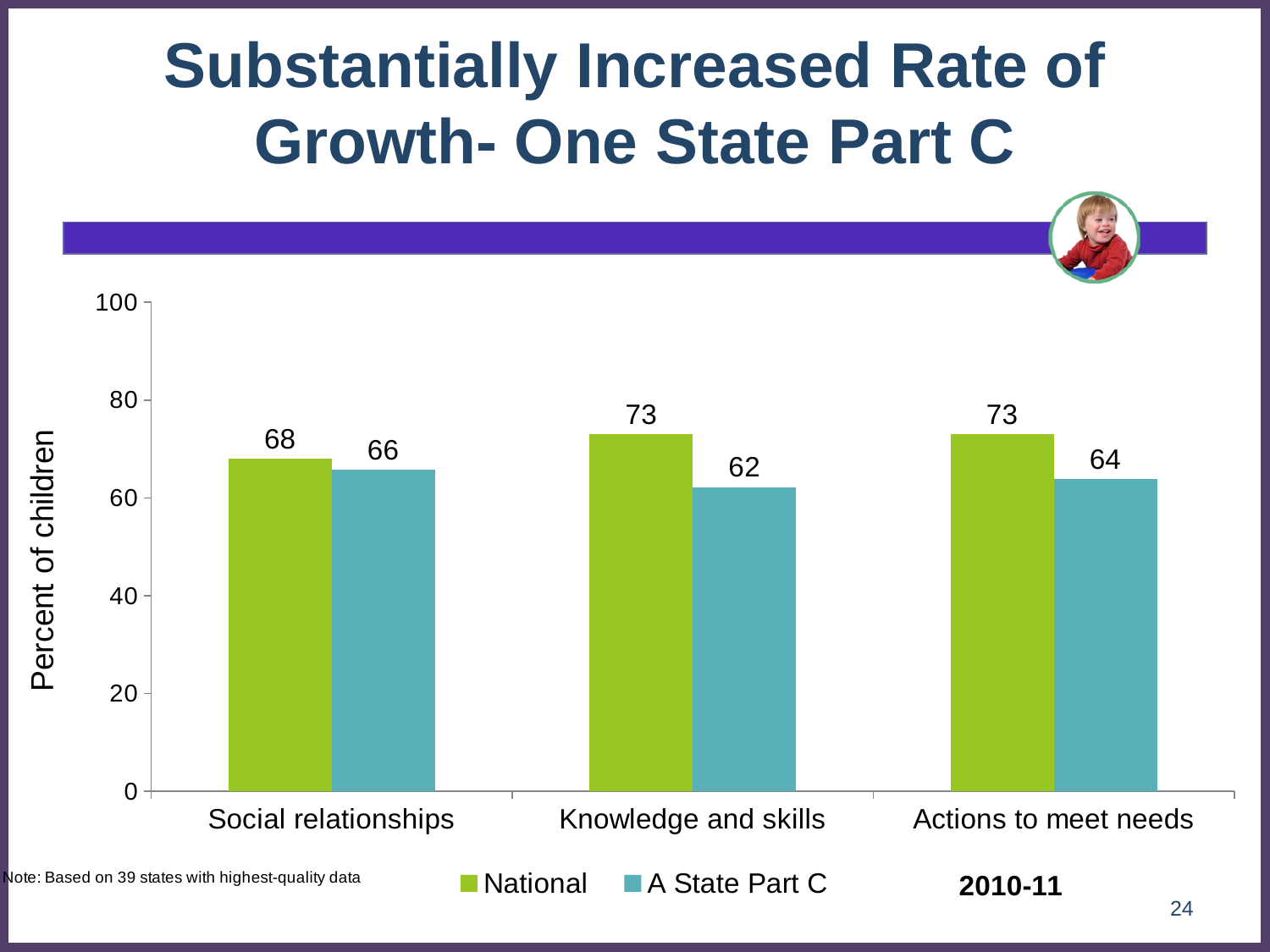
What is the A State Part C value for Knowledge and skills? 62 Which is larger for Social relationships, the National value or the A State Part C value? National How many categories are shown on the x axis? 3 What is the label of the y axis? Percent of children Which category has the lowest National value? Social relationships What is the National value for Social relationships? 68 What is the difference between the National and A State Part C values for Actions to meet needs? 9 What is the difference between the National and A State Part C values for Knowledge and skills? 11 How many series does the legend list? 2 What kind of chart is shown on the slide? Bar chart Which category has the highest A State Part C value? Social relationships What is the A State Part C value for Actions to meet needs? 64